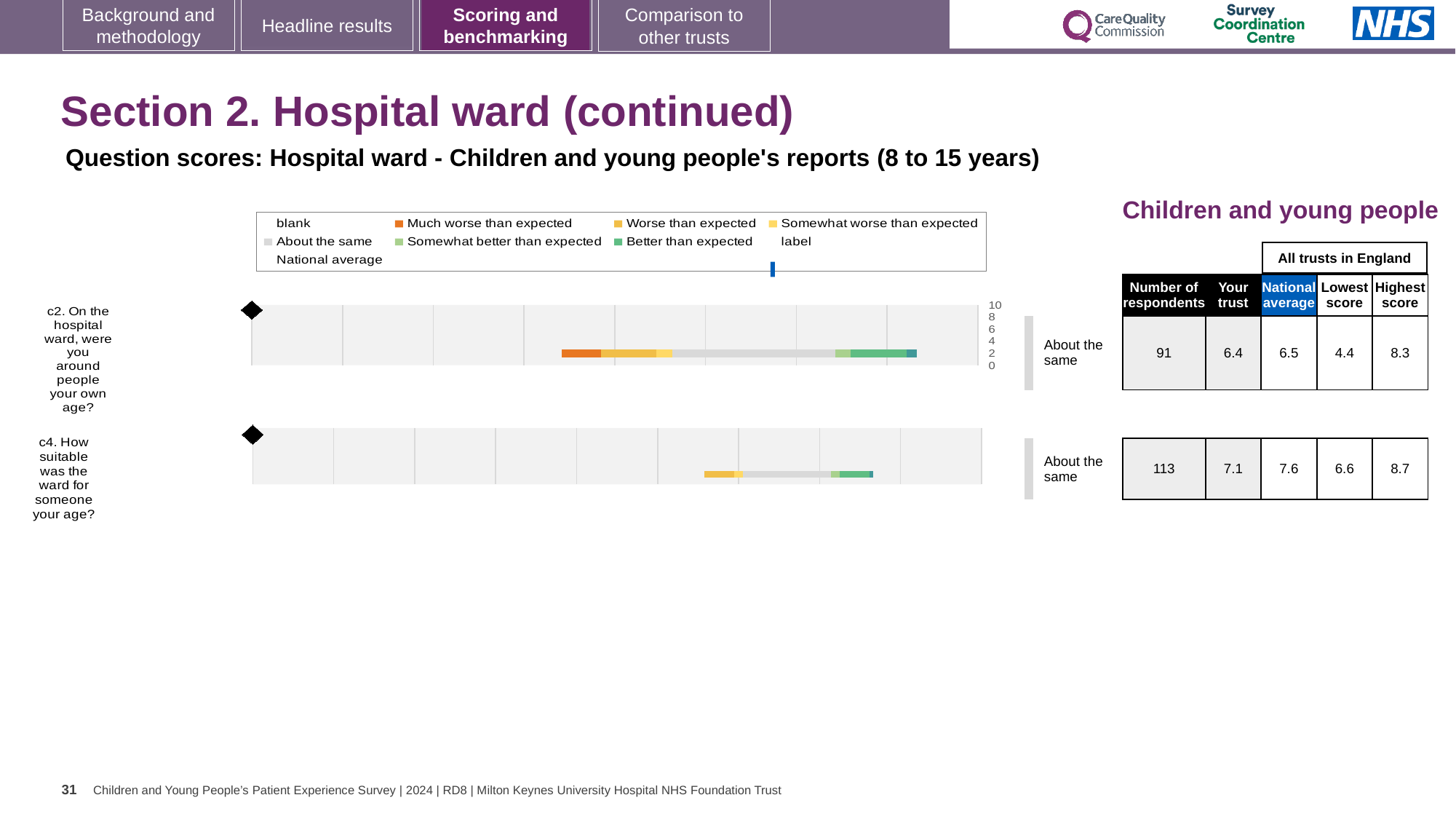
For question c4, what is the difference between the national average and the 'Your trust' score? 0.5 What kind of chart is used to show the question scores on this slide? Bar chart How many respondents answered question c4? 113 What is the lowest score across all trusts in England for question c4? 6.6 For question c2, what is the difference between the highest and lowest scores across all trusts in England? 3.9 What is the highest score across all trusts in England for question c2? 8.3 Which question has more respondents, c2 or c4? c4 What is the national average score for question c4 (How suitable was the ward for someone your age?)? 7.6 What benchmarking category is shown for question c2? About the same What is the 'Your trust' score for question c2 (On the hospital ward, were you around people your own age?)? 6.4 Which question has the higher 'Your trust' score, c2 or c4? c4 How many questions are charted on this slide? 2